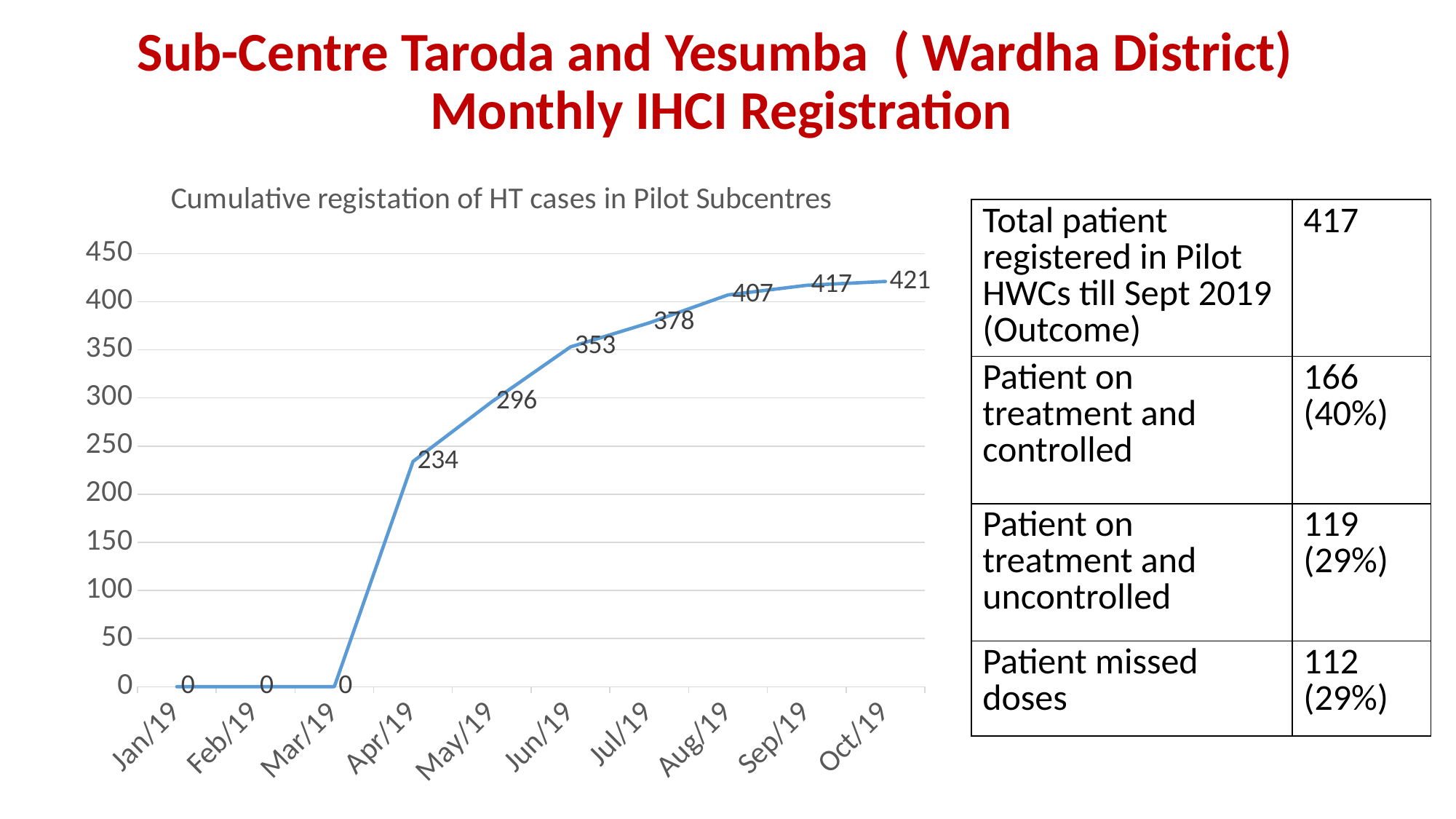
Which is larger, the value for Jun/19 or the value for May/19? Jun/19 What is the cumulative registration value for Apr/19? 234 Is the value for Jun/19 greater or less than 300? greater What is the title of the chart? Cumulative registation of HT cases in Pilot Subcentres Which month has the highest cumulative registration value? Oct/19 What is the cumulative registration value for Jul/19? 378 Do the values rise or fall from Apr/19 to Oct/19? rise How many months are plotted on the x axis? 10 What is the difference between the values for May/19 and Apr/19? 62 What is the difference between the values for Sep/19 and Aug/19? 10 What kind of chart is shown on the slide? line chart What is the cumulative registration value for Oct/19? 421